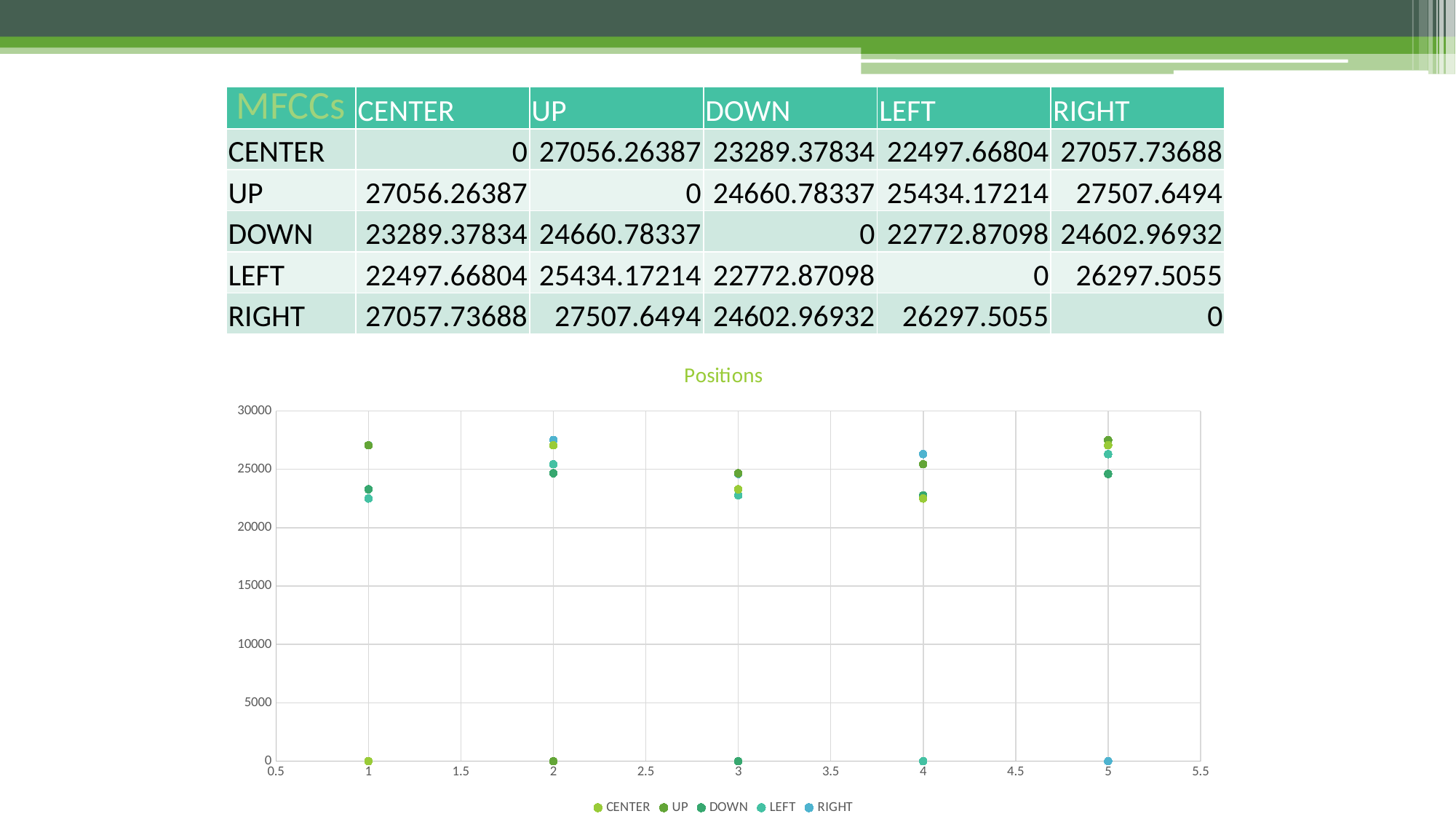
In the 'Positions' chart, is the highest point at x = 3 greater or less than 30000? less What is the title of the chart on the slide? Positions What is the highest tick value shown on the y axis of the 'Positions' chart? 30000 At how many distinct x positions are points plotted in the 'Positions' chart? 5 Which series are listed in the legend of the 'Positions' chart? CENTER, UP, DOWN, LEFT, RIGHT How many series does the legend of the 'Positions' chart list? 5 In the 'Positions' chart, is the highest point at x = 1 greater or less than 25000? greater In the 'Positions' chart, is the highest point at x = 2 greater or less than 25000? greater What kind of chart is the 'Positions' chart? scatter chart